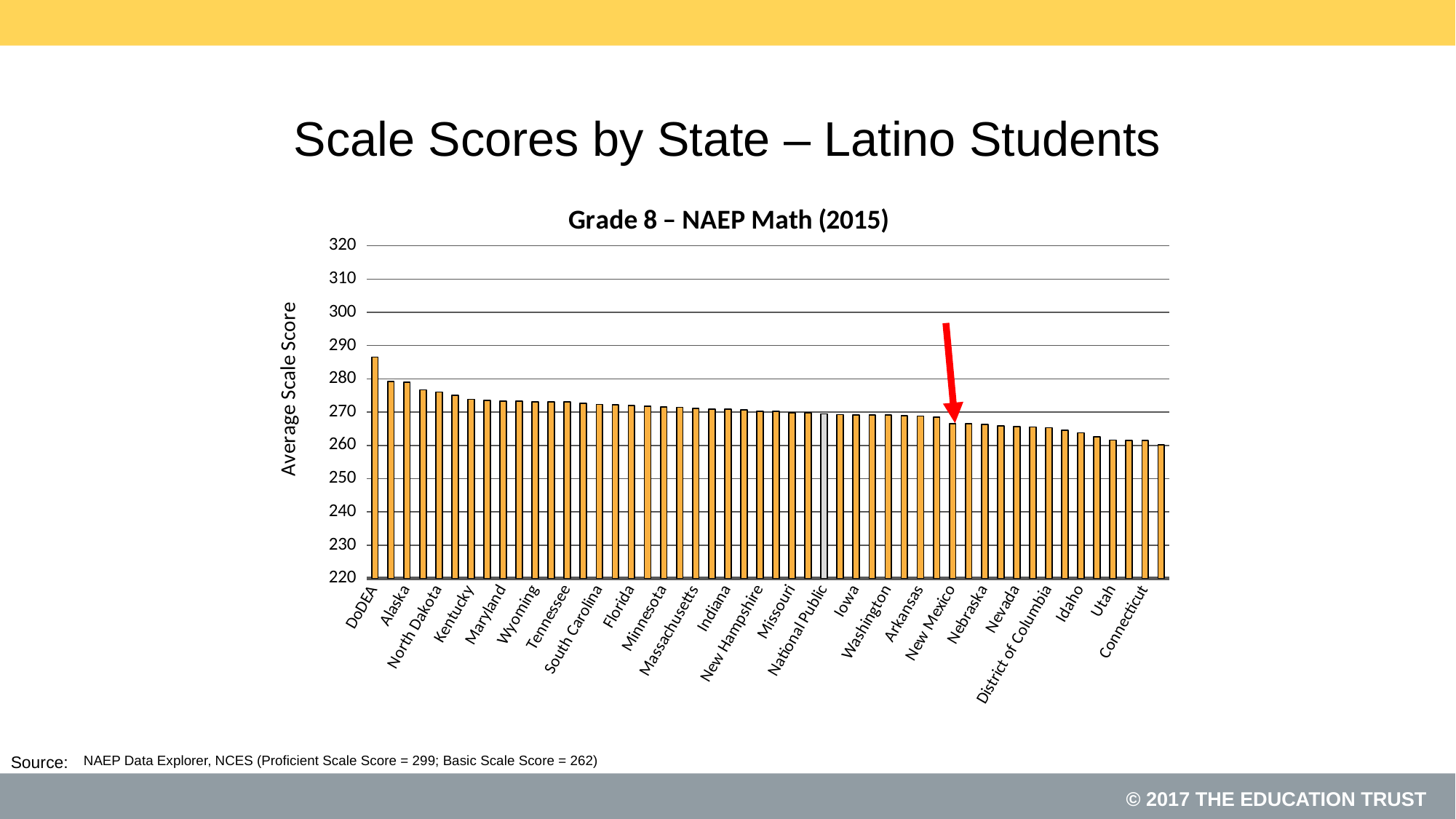
Is the value for DoDEA greater or less than 280? greater Which state or jurisdiction has the highest average scale score in the chart? DoDEA What kind of chart is shown on the slide? Bar chart Is the value for National Public greater or less than 280? less Is the value for Connecticut greater or less than 270? less Which has a higher average scale score, Alaska or Utah? Alaska Do the bar values rise or fall moving from left to right along the x axis? Fall What is the label on the vertical axis of the chart? Average Scale Score Which has a higher average scale score, DoDEA or Connecticut? DoDEA What is the title of the chart? Grade 8 – NAEP Math (2015)